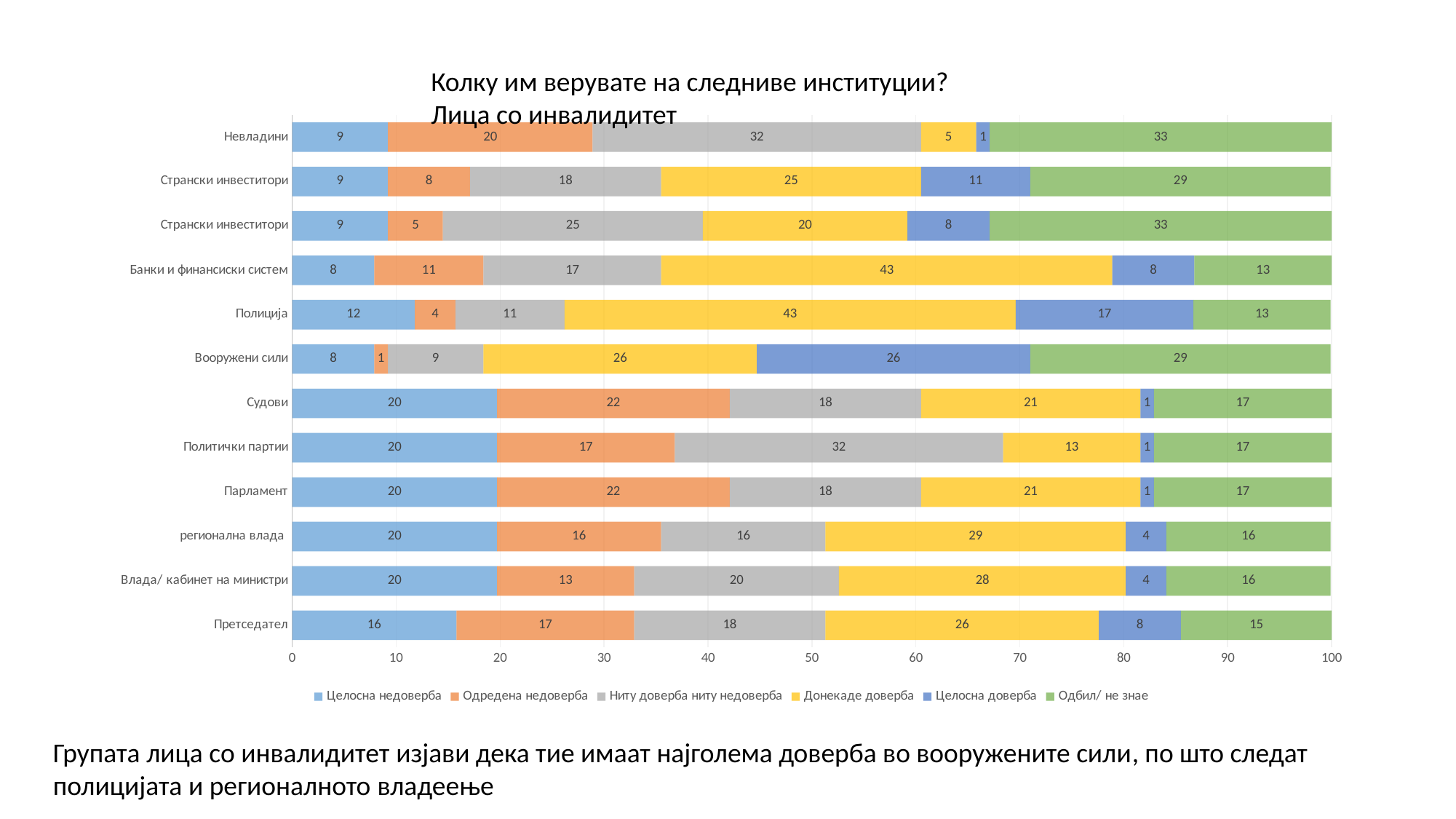
What kind of chart is shown on the slide? Stacked bar chart Which category has the highest value for Целосна доверба? Вооружени сили What is the value of Донекаде доверба for Полиција? 43 What is the value of Целосна доверба for Вооружени сили? 26 What is the value of Одбил/ не знае for Невладини? 33 Which category has the lowest value for Одредена недоверба? Вооружени сили Which has a larger Целосна доверба value, Полиција or Претседател? Полиција What is the difference between the Одредена недоверба values for Судови and Претседател? 5 Which legend entry is shown in green? Одбил/ не знае What is the total of the stacked bar for Полиција? 100 How many categories (institutions) are shown on the chart? 12 How many series does the legend list? 6